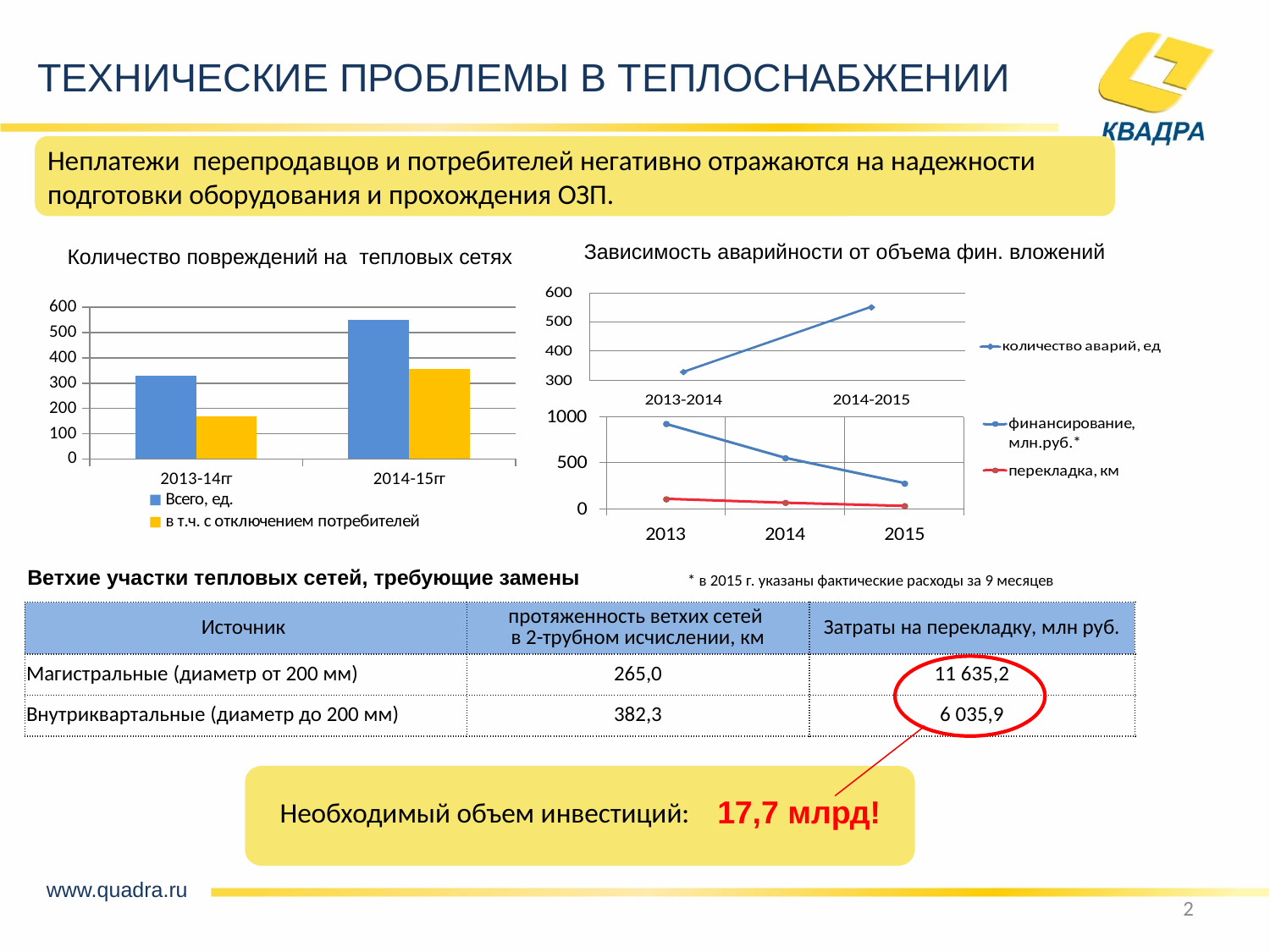
In the chart "Количество повреждений на тепловых сетях", which is larger in 2013-14гг: "Всего, ед." or "в т.ч. с отключением потребителей"? Всего, ед. In the chart "Количество повреждений на тепловых сетях", which period has the higher value for "Всего, ед."? 2014-15гг In the lower right chart under "Зависимость аварийности от объема фин. вложений", which series is shown in red? перекладка, км In the lower right chart under "Зависимость аварийности от объема фин. вложений", does "финансирование, млн.руб.*" rise or fall from 2013 to 2015? fall In the upper right chart under "Зависимость аварийности от объема фин. вложений", is the value for 2014-2015 greater or less than 500? greater In the chart "Количество повреждений на тепловых сетях", is the value for "Всего, ед." in 2014-15гг greater or less than 500? greater In the chart "Количество повреждений на тепловых сетях", how many periods are shown on the x axis? 2 In the lower right chart under "Зависимость аварийности от объема фин. вложений", is the value for "финансирование, млн.руб.*" in 2013 greater or less than 500? greater In the chart "Количество повреждений на тепловых сетях", how many series does the legend list? 2 What kind of chart is "Количество повреждений на тепловых сетях"? bar chart In the upper right chart under "Зависимость аварийности от объема фин. вложений", does the number of accidents (количество аварий, ед) rise or fall from 2013-2014 to 2014-2015? rise